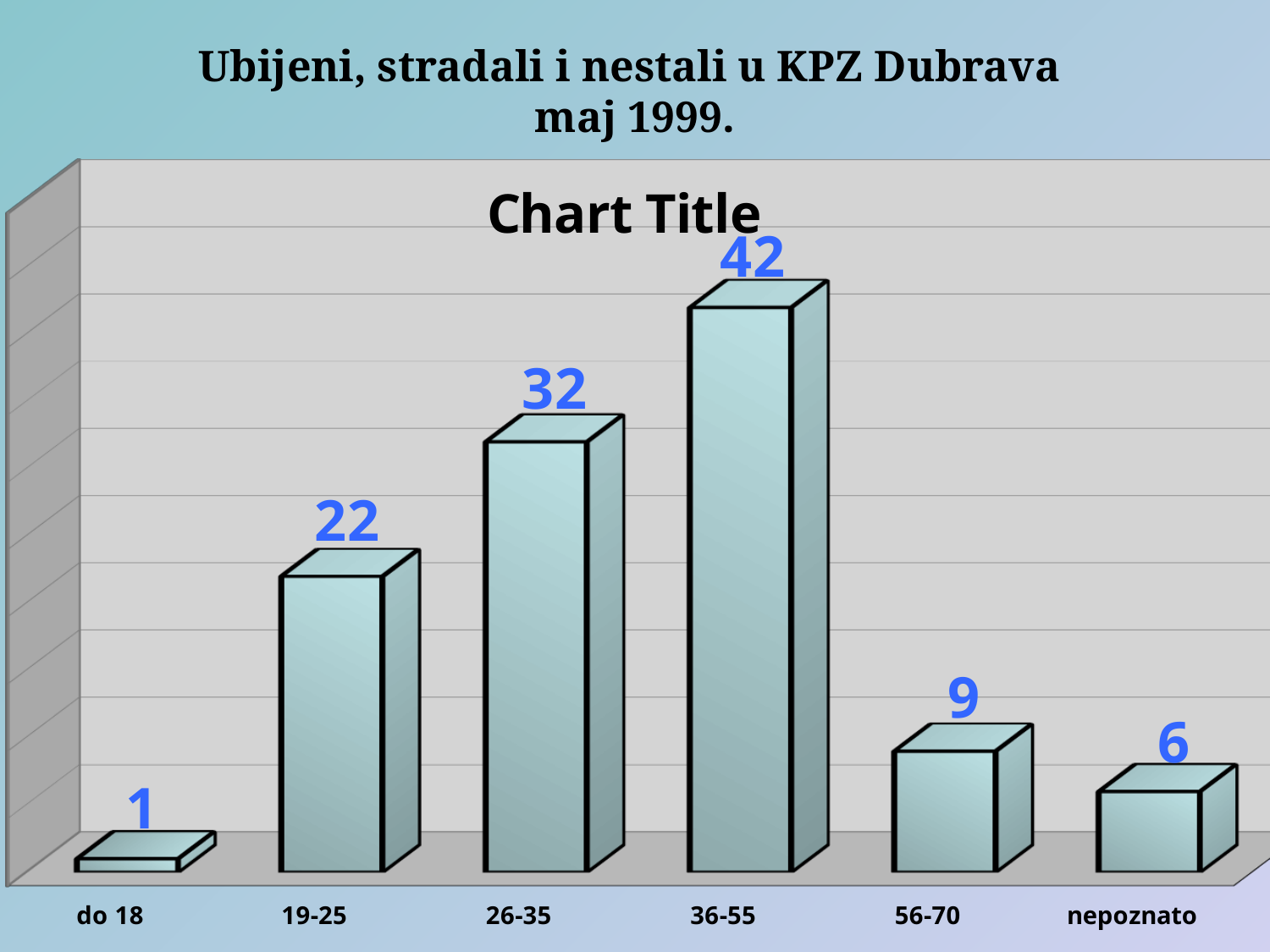
What is the title printed above the chart area? Chart Title What is the value for the 36-55 category? 42 Which category has the highest value? 36-55 Which category has the lowest value? do 18 Which is larger, the value for 19-25 or the value for 56-70? 19-25 What is the value for the nepoznato category? 6 What is the difference between the values for 36-55 and 26-35? 10 What is the value for the 19-25 category? 22 How many categories are shown on the x axis? 6 What is the total of all the values shown in the chart? 112 What kind of chart is shown on the slide? bar chart What is the difference between the values for 56-70 and nepoznato? 3